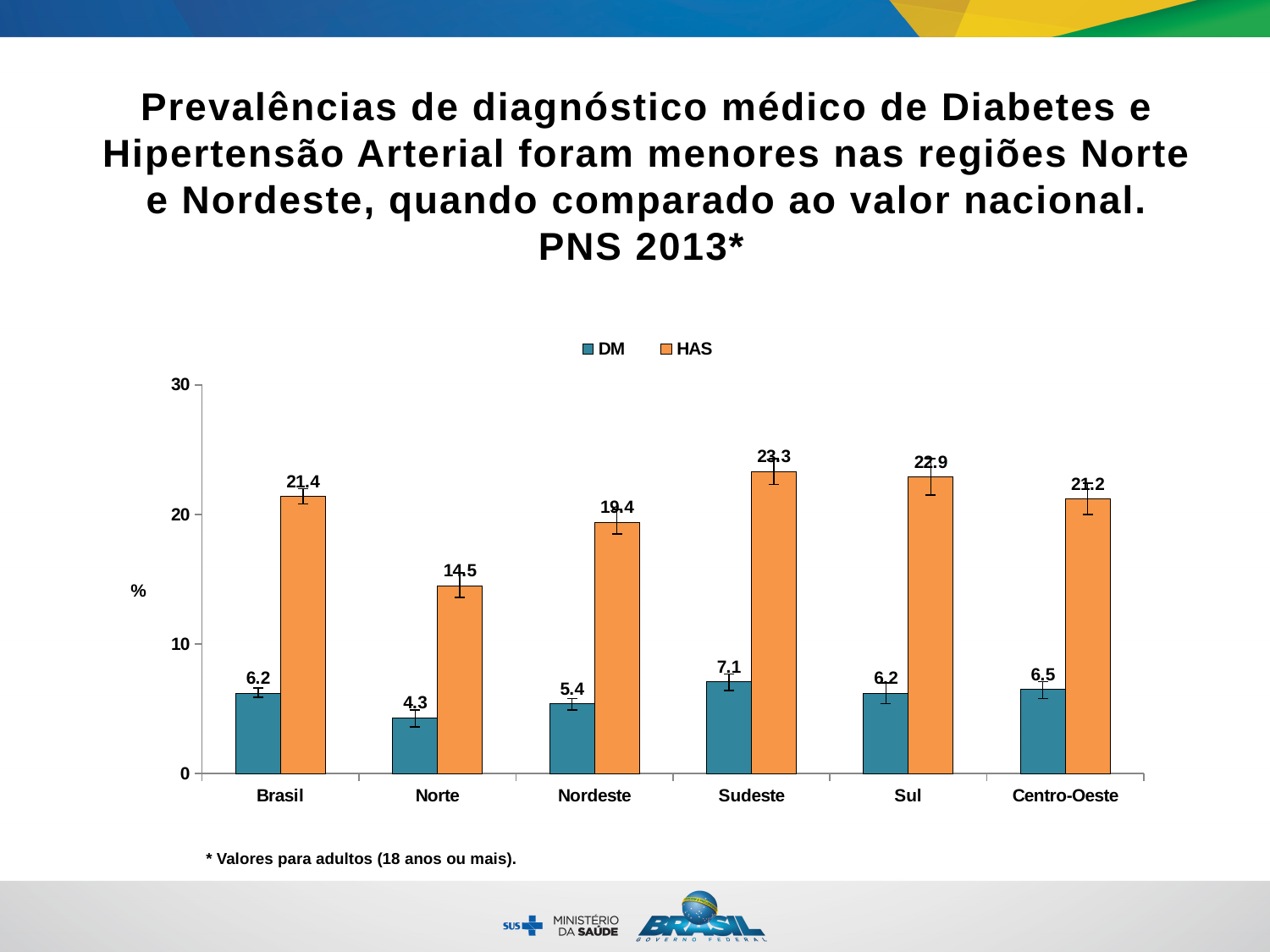
Which is larger, the DM value for Sudeste or the DM value for Centro-Oeste? Sudeste What is the DM value for Norte? 4.3 How many regions are shown on the x axis? 6 How many series does the legend list? 2 What kind of chart is shown on the slide? bar chart Which region has the highest HAS value? Sudeste Which region has the lowest DM value? Norte What is the HAS value for Sudeste? 23.3 Is the HAS value for Nordeste greater or less than 20? less What is the HAS value for Brasil? 21.4 What is the difference between the HAS values for Sudeste and Norte? 8.8 What are the two series named in the legend? DM and HAS